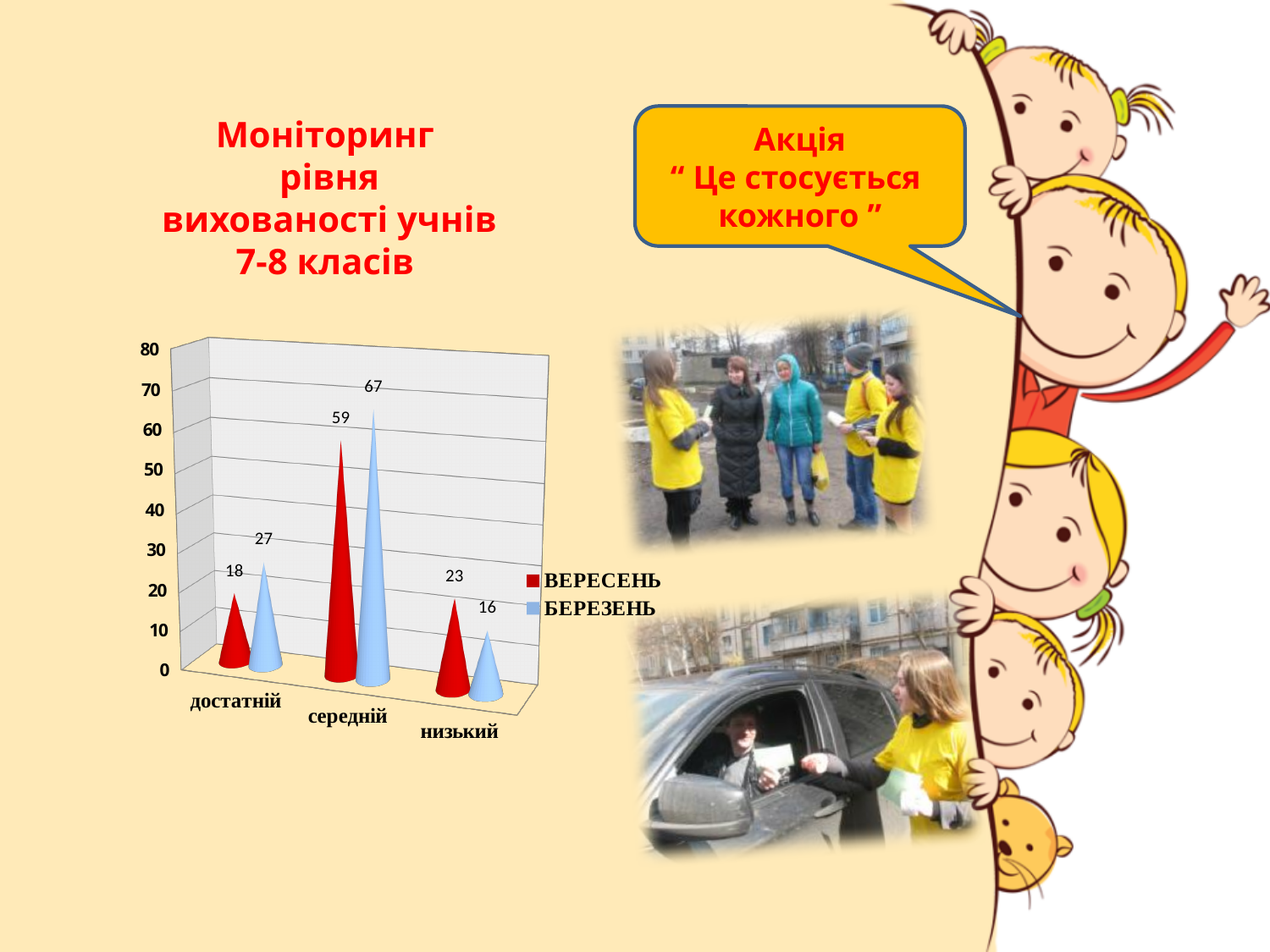
What is the value for БЕРЕЗЕНЬ in the низький category? 16 What is the value for ВЕРЕСЕНЬ in the середній category? 59 How many categories are shown on the x axis of the chart? 3 What is the value for БЕРЕЗЕНЬ in the достатній category? 27 How many series does the chart legend list? 2 Which colour represents the ВЕРЕСЕНЬ series in the chart? red Which category has the lowest value for ВЕРЕСЕНЬ? достатній In the низький category, which series has the larger value, ВЕРЕСЕНЬ or БЕРЕЗЕНЬ? ВЕРЕСЕНЬ Is the value for ВЕРЕСЕНЬ in the середній category greater or less than 50? greater What is the difference between the БЕРЕЗЕНЬ and ВЕРЕСЕНЬ values in the середній category? 8 Which category has the highest value for БЕРЕЗЕНЬ? середній What kind of chart is shown on the slide? bar chart